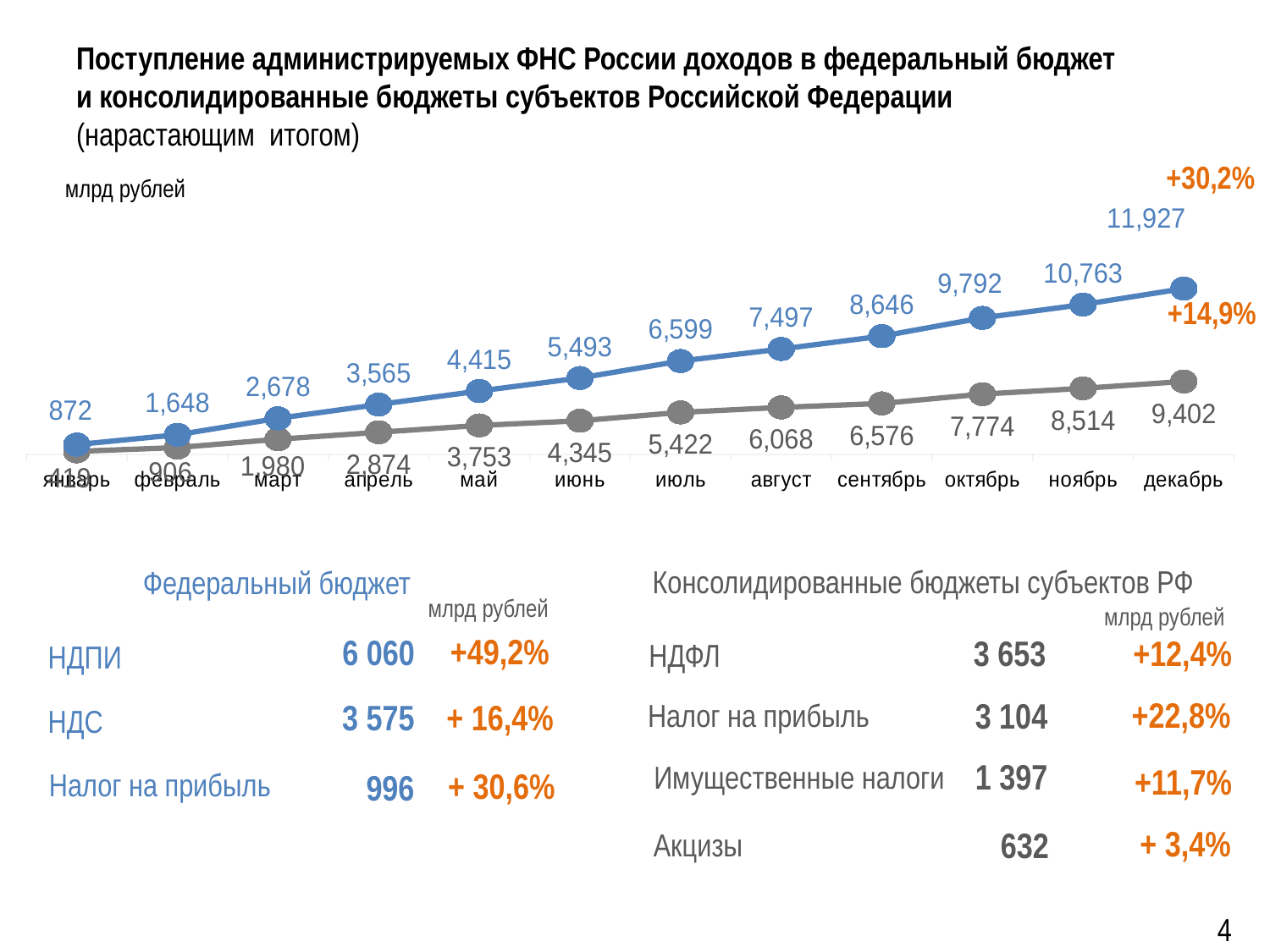
How many months are plotted along the x axis of the chart? 12 What is the difference between the blue and grey line values for декабрь? 2,525 What is the difference between the blue line values for ноябрь and октябрь? 971 Do the values of the grey line rise or fall from январь to декабрь? rise What is the value of the blue line for июнь? 5,493 Which line has the higher value in август, the blue or the grey? blue What is the value of the grey line for сентябрь? 6,576 What is the value of the grey line for декабрь? 9,402 What is the value of the blue line for декабрь? 11,927 In which month does the blue line reach its highest value? декабрь What kind of chart is shown on the slide? line chart What is the value of the blue line for январь? 872